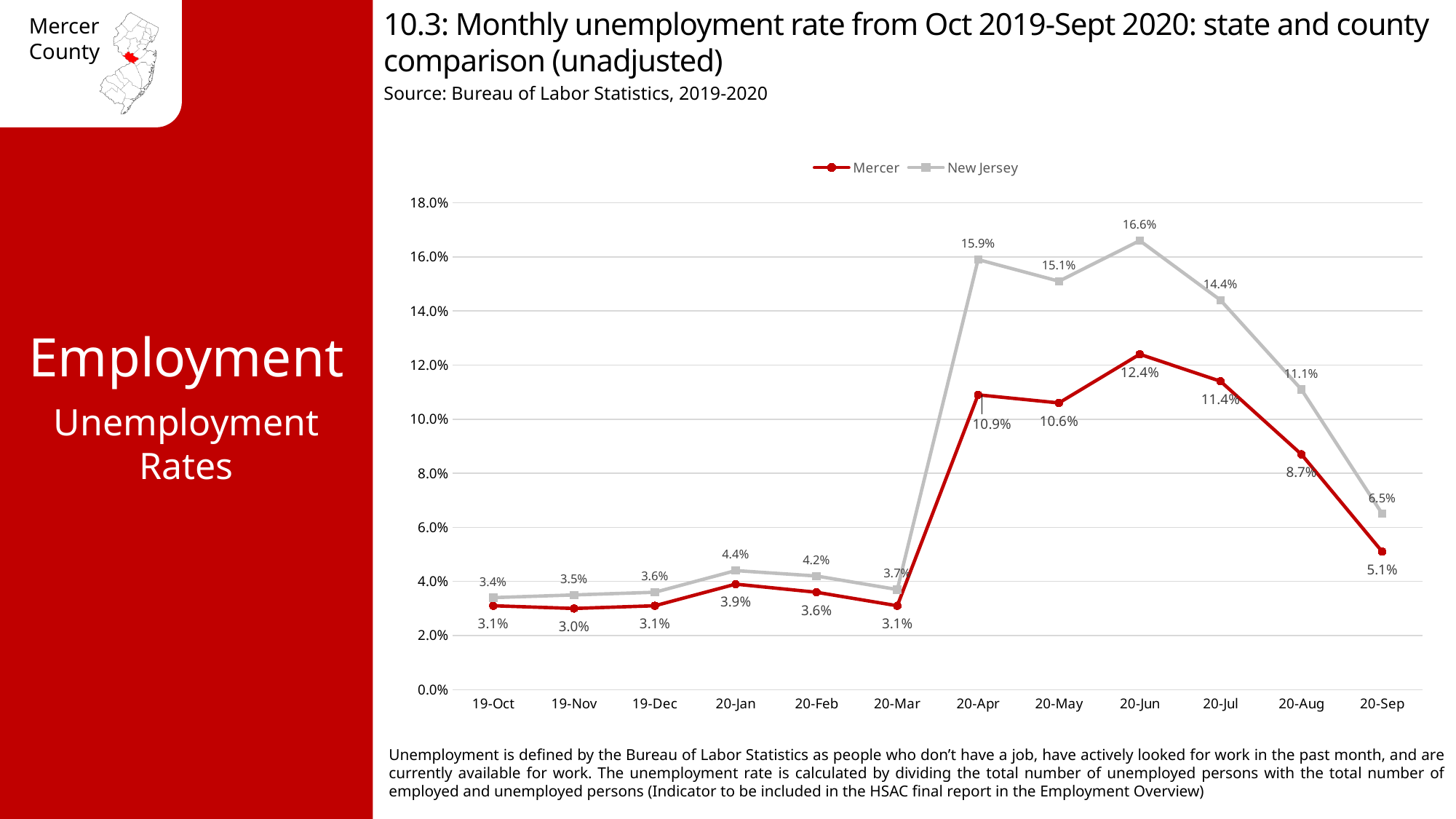
In which month was the Mercer unemployment rate lowest? 19-Nov What was the Mercer unemployment rate in 20-Jun? 12.4% Did the New Jersey unemployment rate rise or fall from 20-Jun to 20-Sep? Fall What was the Mercer unemployment rate in 20-Sep? 5.1% What is the difference between the New Jersey and Mercer unemployment rates in 20-Apr? 5.0% How many series does the legend list? 2 Which series had the higher unemployment rate in 20-Jul, Mercer or New Jersey? New Jersey In which month did New Jersey reach its highest unemployment rate? 20-Jun How many months are shown on the x axis? 12 Is the Mercer unemployment rate in 20-May greater or less than 10.0%? greater What was the New Jersey unemployment rate in 20-Apr? 15.9% What type of chart is shown on the slide? Line chart